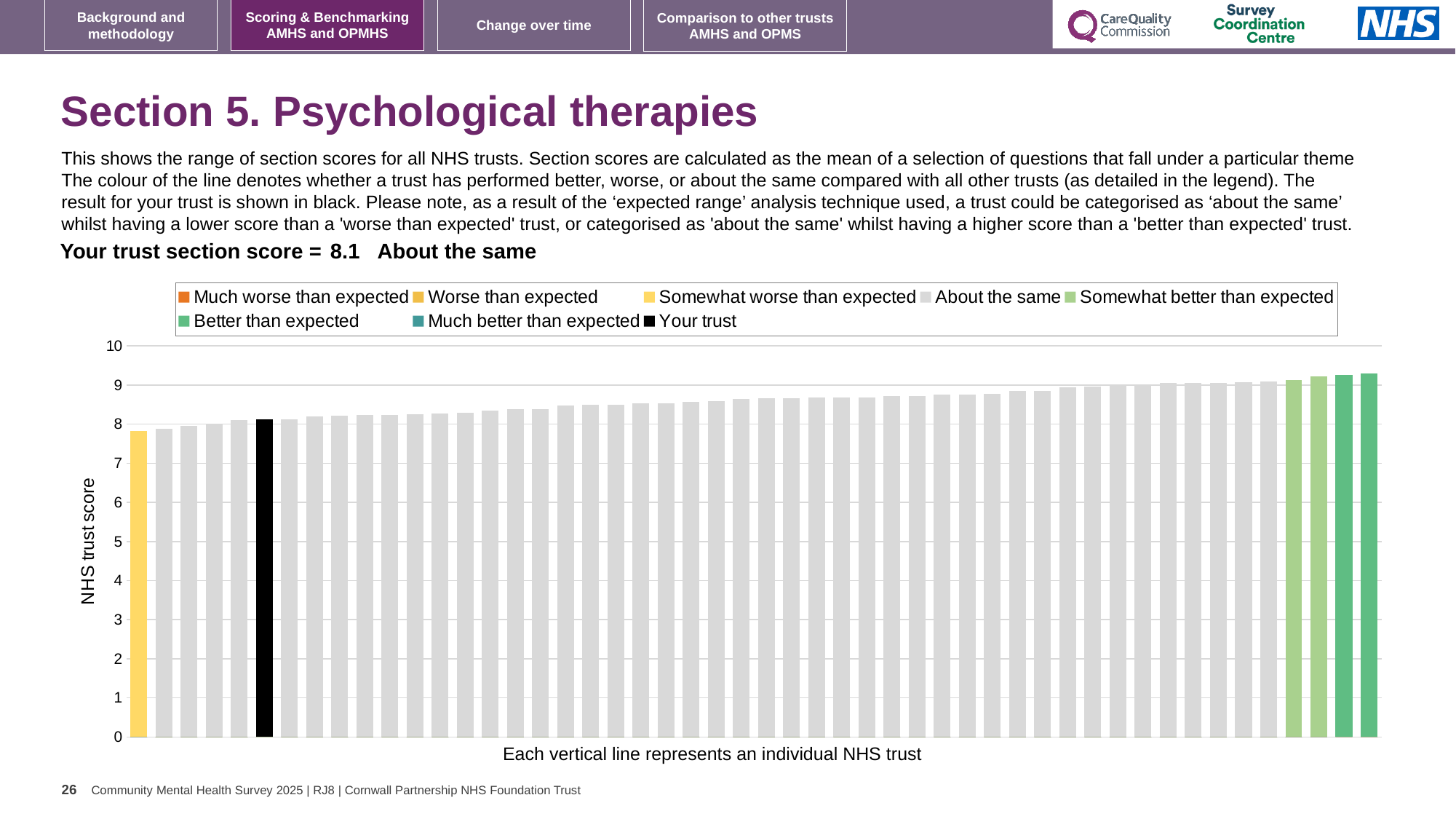
How many entries does the chart legend list? 8 What colour is the bar representing your trust? black Is the value of the shortest bar greater or less than 7? greater Do the bar values rise or fall from left to right along the x axis? rise What is the label on the y axis? NHS trust score Which category is your trust placed in for this section? About the same How many bars are coloured as 'Better than expected'? 2 What kind of chart is shown on the slide? bar chart What is the section score for your trust? 8.1 Is the value for your trust greater or less than 8? greater Is the value of the tallest bar greater or less than 9? greater Which is larger, the value for your trust or the value of the rightmost bar? the rightmost bar